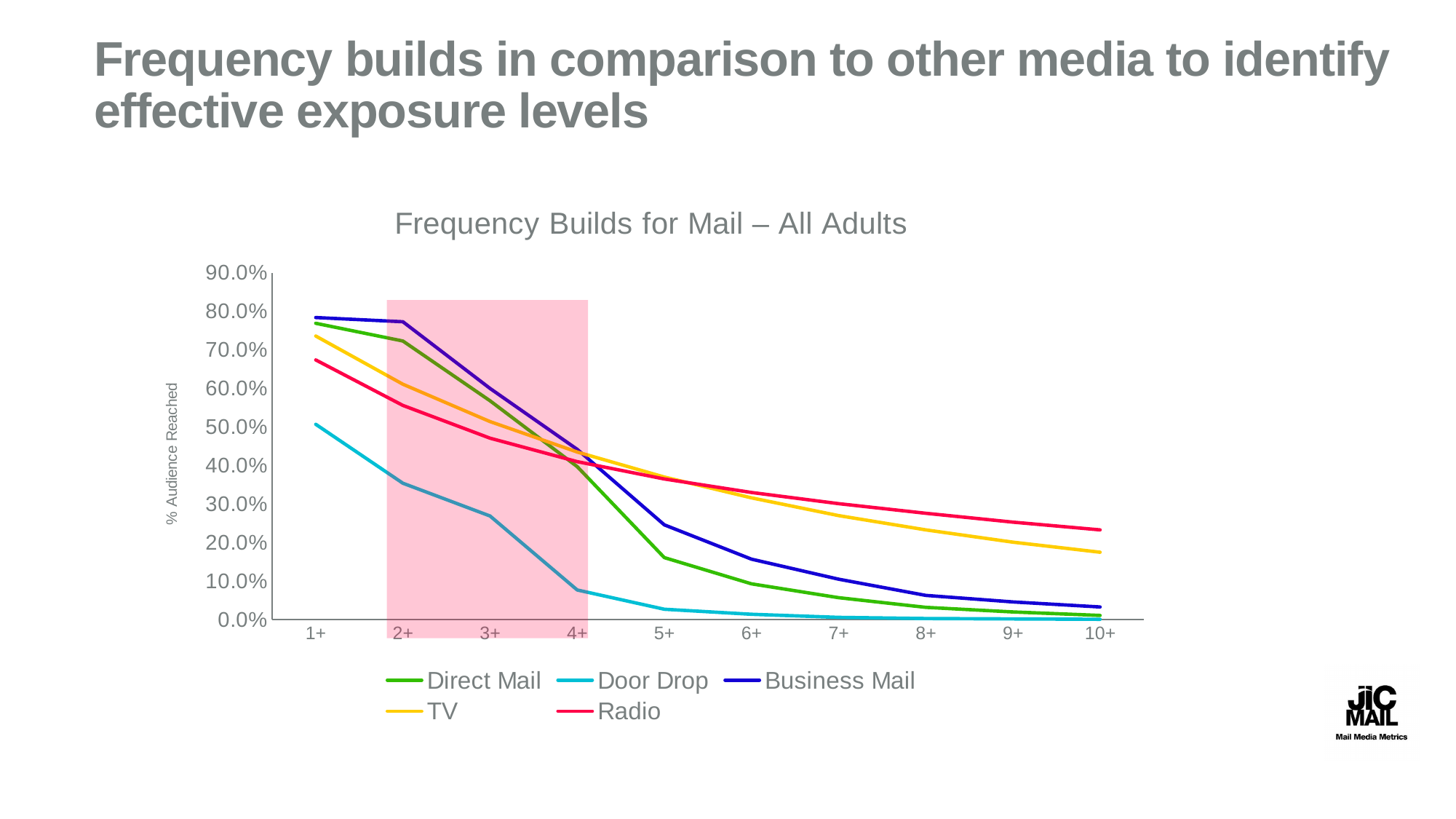
Which series has the highest value at 10+? Radio At 10+, which is larger, Radio or TV? Radio Is the value for Door Drop at 4+ greater or less than 10.0%? less How many series does the legend list? 5 What kind of chart is shown on the slide? Line chart At 5+, which is larger, Business Mail or Direct Mail? Business Mail What is the label on the vertical axis? % Audience Reached Is the value for Radio at 10+ greater or less than 20.0%? greater Do the values for Direct Mail rise or fall as frequency increases from 1+ to 10+? Fall What is the title of the chart? Frequency Builds for Mail – All Adults Which series has the lowest value at 1+? Door Drop How many frequency categories are shown on the x axis? 10